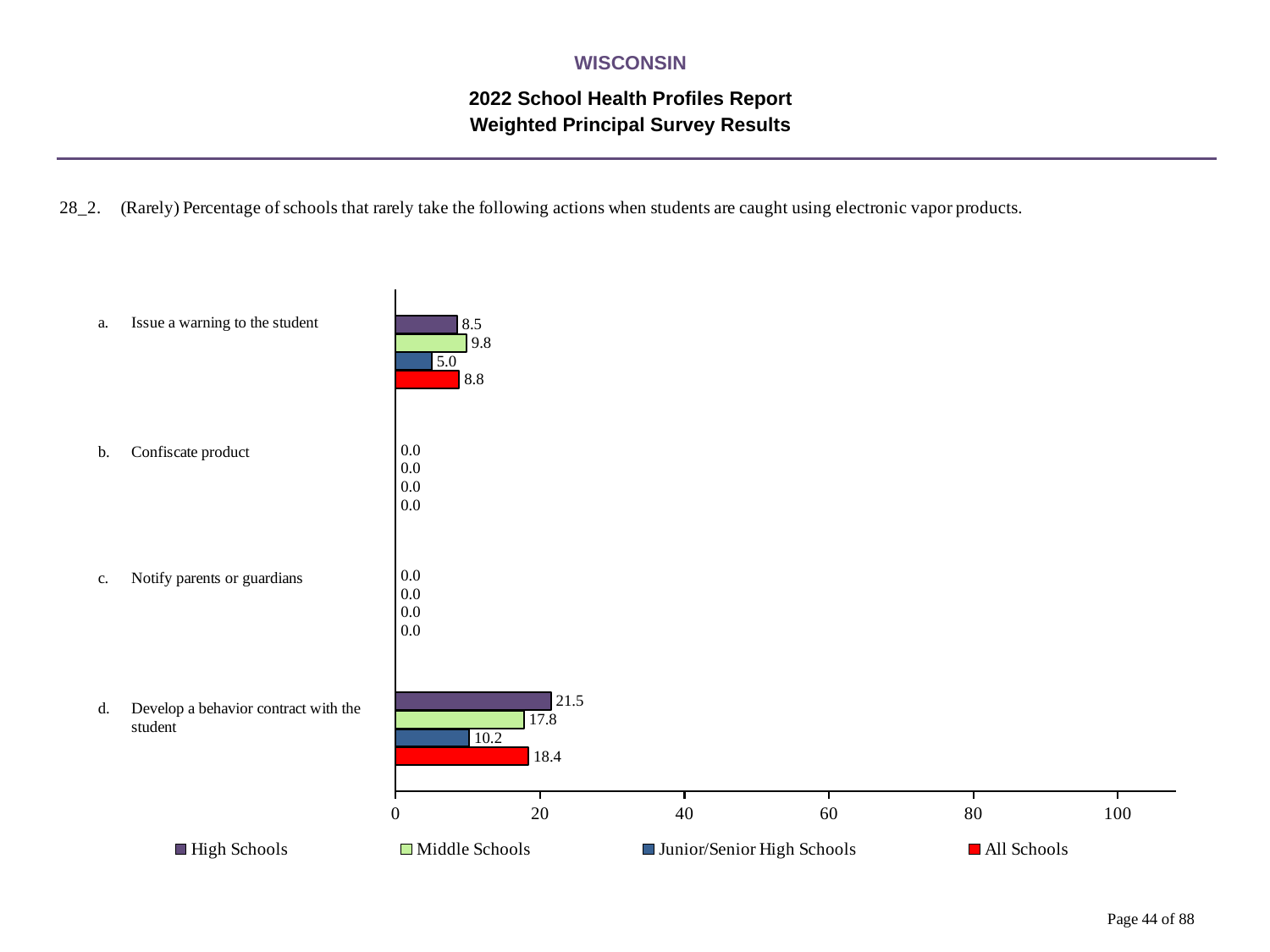
Is the High Schools value for 'Develop a behavior contract with the student' greater or less than 20? greater Which series has the highest value for 'Develop a behavior contract with the student'? High Schools What is the value for Middle Schools for 'Confiscate product'? 0.0 Which series has the lowest value for 'Issue a warning to the student'? Junior/Senior High Schools How many series does the legend list? 4 How many action categories are shown on the chart? 4 What is the difference between the High Schools and Middle Schools values for 'Develop a behavior contract with the student'? 3.7 What is the value for All Schools for 'Develop a behavior contract with the student'? 18.4 What kind of chart is shown on the slide? Bar chart Which is larger for 'Issue a warning to the student': the Middle Schools value or the All Schools value? Middle Schools What is the value for High Schools for 'Issue a warning to the student'? 8.5 What is the value for Junior/Senior High Schools for 'Develop a behavior contract with the student'? 10.2